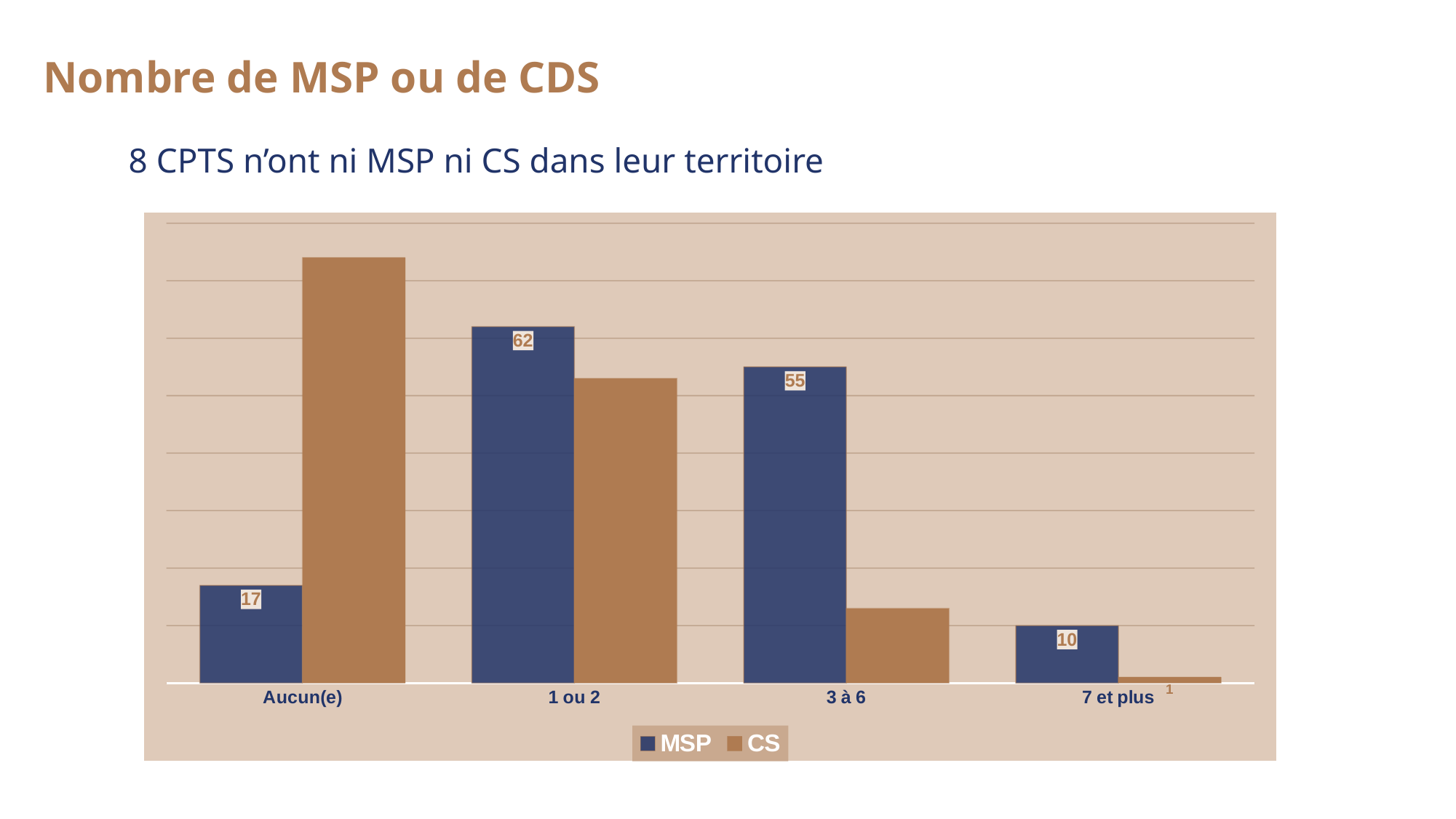
What is the CS value for the category "7 et plus"? 1 Which category has the lowest MSP value? 7 et plus What is the difference between the MSP values for "1 ou 2" and "3 à 6"? 7 What is the MSP value for the category "Aucun(e)"? 17 How many series does the legend list? 2 What is the MSP value for the category "1 ou 2"? 62 Which category has the highest CS value? Aucun(e) What kind of chart is shown on the slide? Bar chart Which category has the highest MSP value? 1 ou 2 How many categories are shown on the x axis? 4 What is the MSP value for the category "3 à 6"? 55 For the category "Aucun(e)", which series has the larger value, MSP or CS? CS